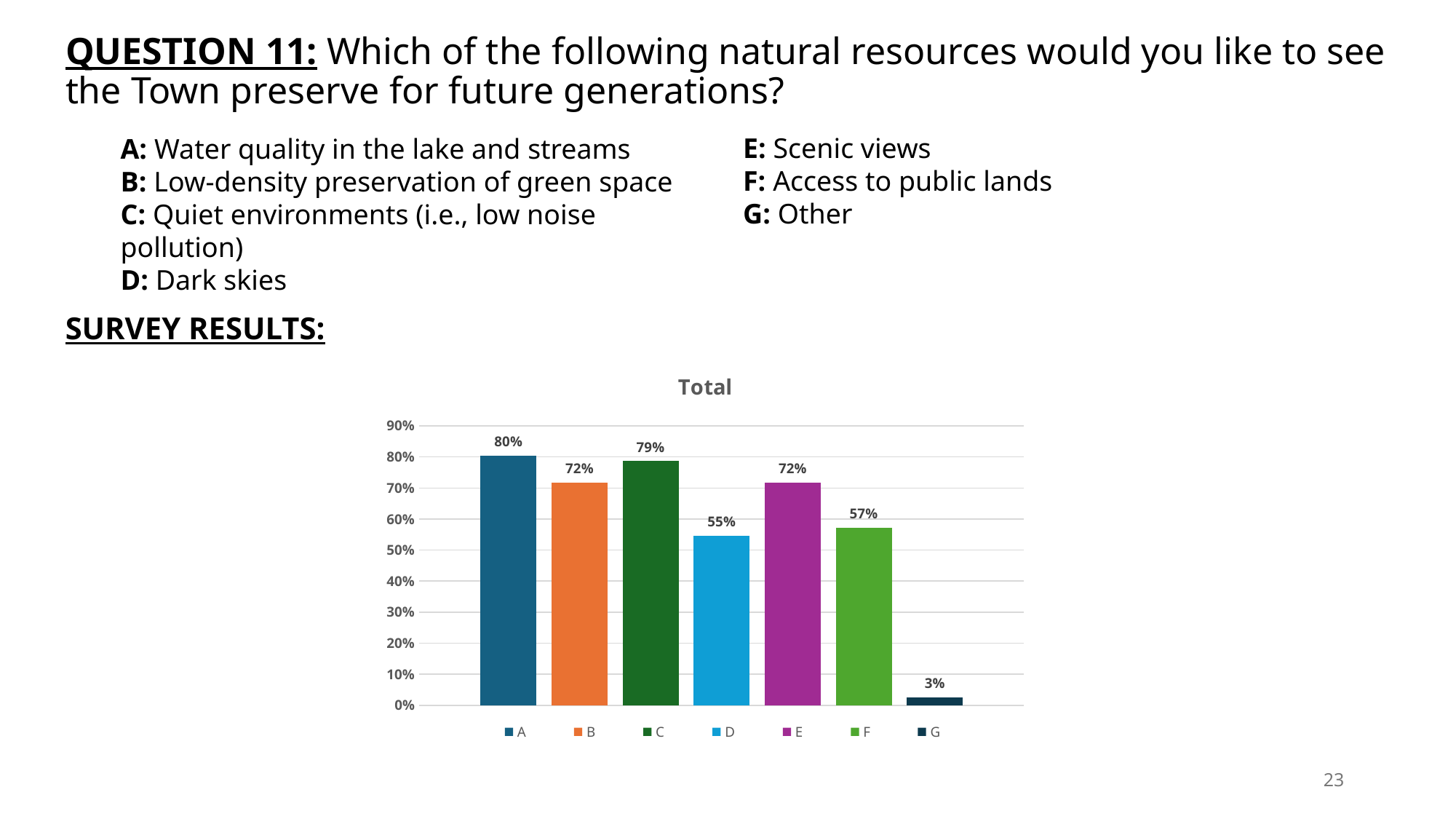
Is the value for E greater or less than 60%? greater What is the value for category G? 3% Which category has the highest value? A What is the difference between the values for A and D? 25% What kind of chart is shown on the slide? Bar chart What is the difference between the values for F and G? 54% What is the value for category D? 55% What is the title of the chart? Total Which is larger, the value for C or the value for F? C How many categories are shown in the chart? 7 Which category has the lowest value? G What is the value for category A? 80%